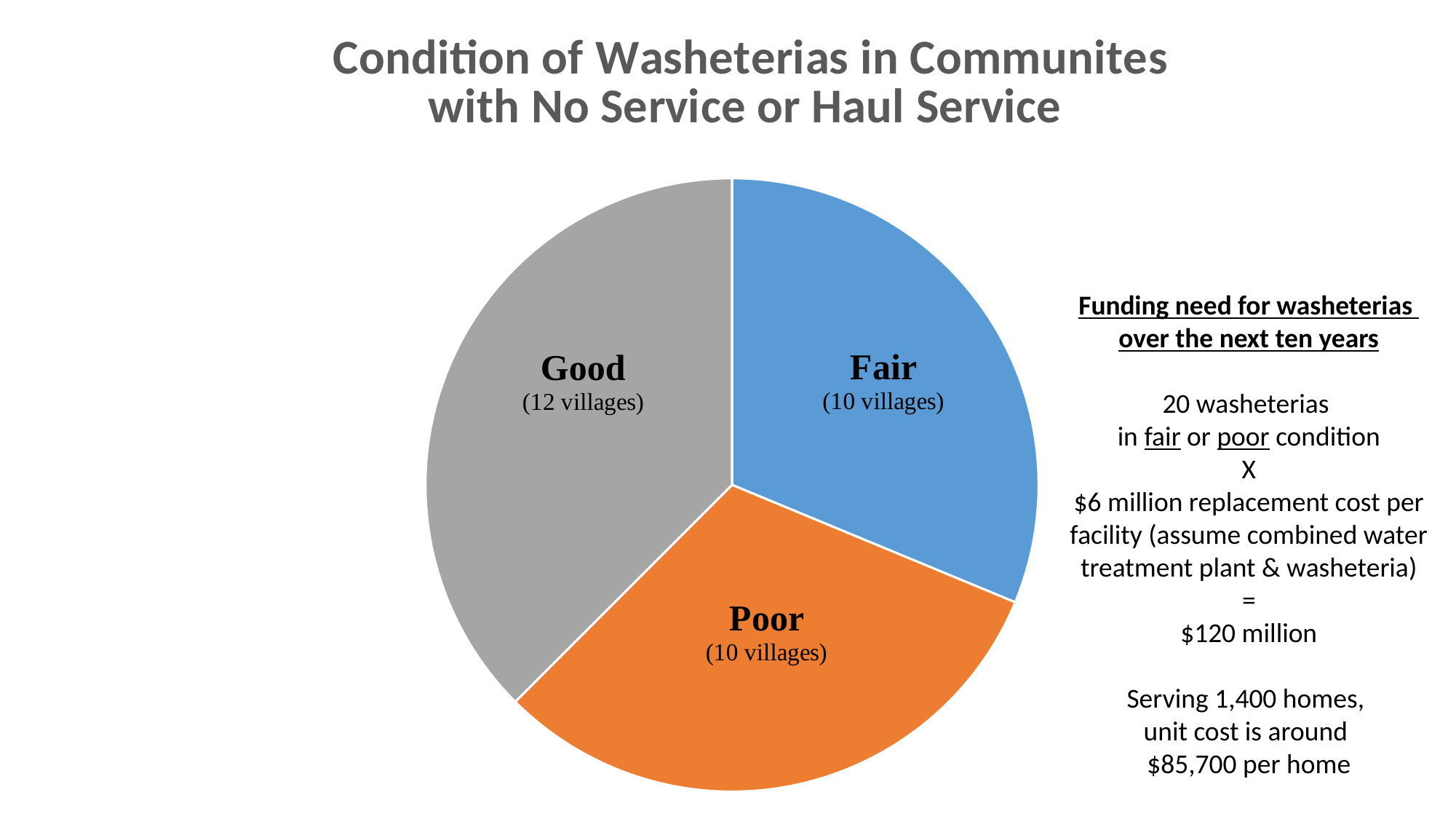
What colour is the Poor slice of the pie chart? Orange How many more villages are in Good condition than in Poor condition? 2 villages How many villages have washeterias in Fair condition? 10 villages How many condition categories does the pie chart show? 3 What share of the villages in the pie chart are in Good condition? 37.5% What is the title of the pie chart? Condition of Washeterias in Communites with No Service or Haul Service Which has more villages, Good or Fair? Good What kind of chart is shown on the slide? Pie chart Which condition category has the largest number of villages? Good How many villages have washeterias in Good condition? 12 villages How many villages have washeterias in Poor condition? 10 villages What is the total number of villages represented in the pie chart? 32 villages